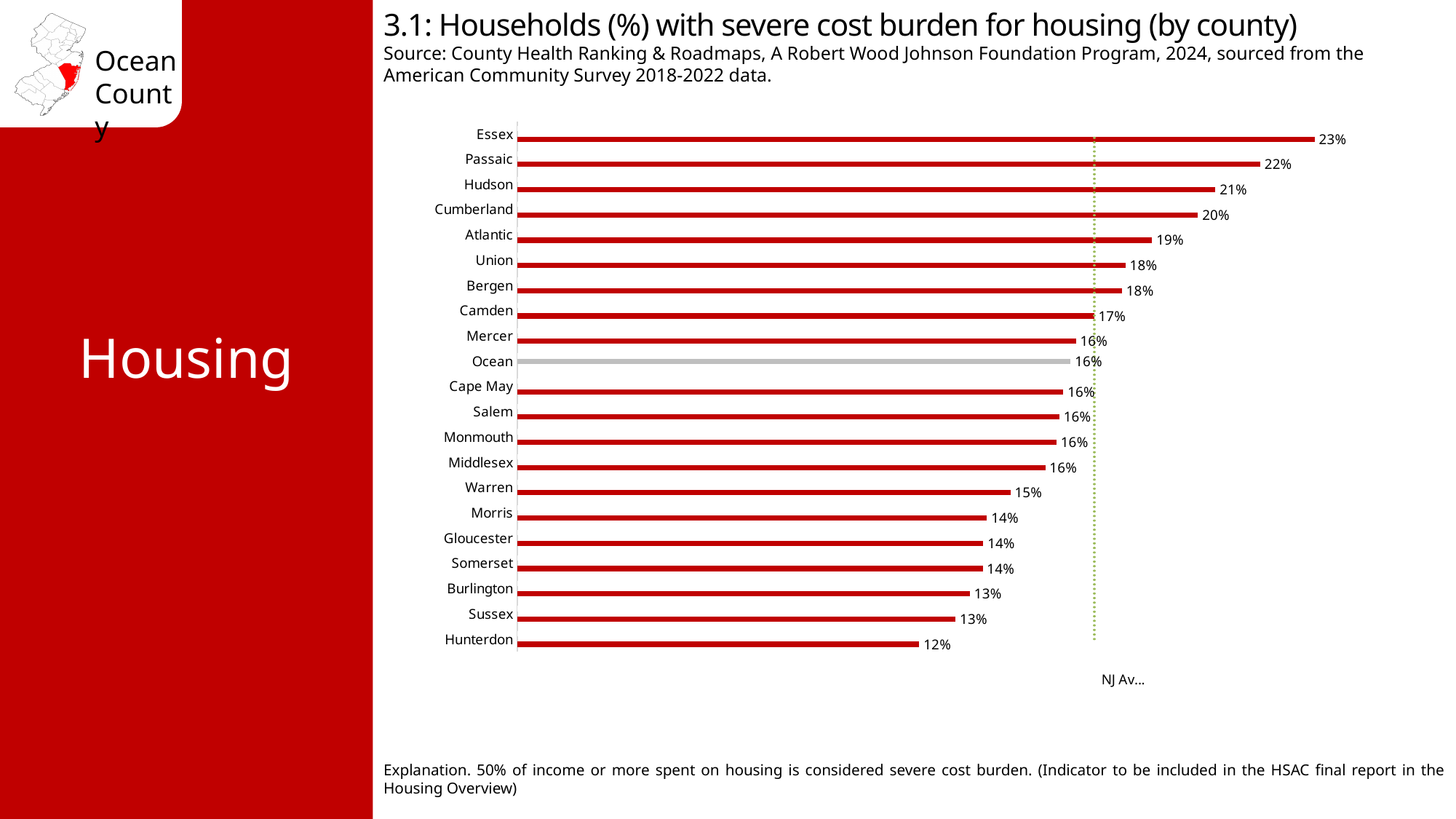
What is the value for Cumberland? 20% What kind of chart is shown on the slide? Bar chart What is the value for Ocean? 16% Which county's bar is shown in grey rather than red? Ocean What is the value for Essex? 23% How many counties are shown in the chart? 21 Which is larger, the value for Hudson or the value for Atlantic? Hudson Which county has the lowest percentage of households with severe cost burden? Hunterdon What is the difference between the values for Passaic and Warren? 7% Which county has the highest percentage of households with severe cost burden? Essex What is the difference between the values for Essex and Hunterdon? 11% What is the value for Hunterdon? 12%